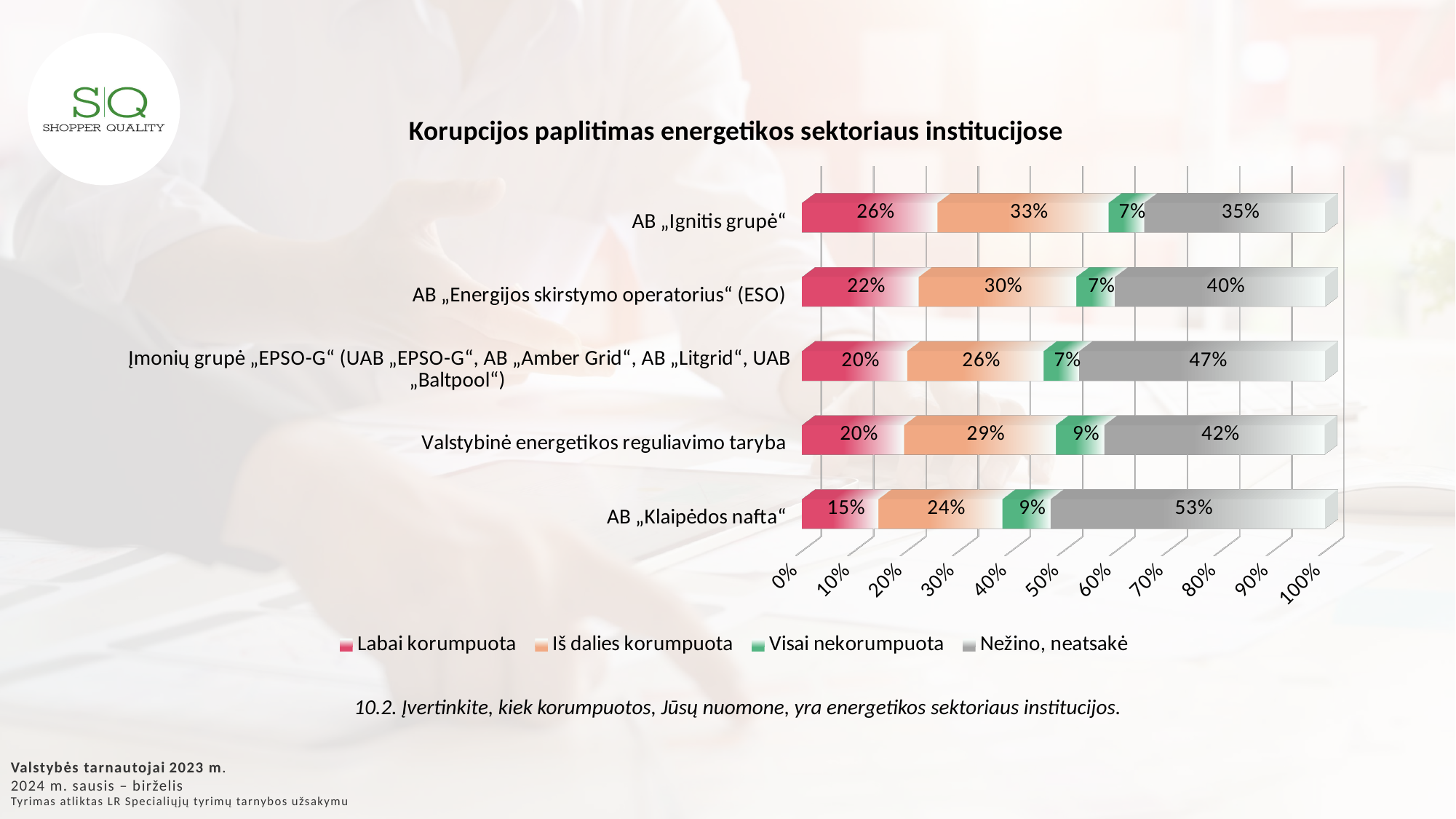
What percentage of respondents rated AB „Ignitis grupė“ as „Labai korumpuota“? 26% What is the „Visai nekorumpuota“ value for Valstybinė energetikos reguliavimo taryba? 9% Which institution has the highest „Labai korumpuota“ share? AB „Ignitis grupė“ What is the title of the chart? Korupcijos paplitimas energetikos sektoriaus institucijose Which institution has the highest „Nežino, neatsakė“ share? AB „Klaipėdos nafta“ How many series does the legend list? 4 Which institution has the lowest „Labai korumpuota“ share? AB „Klaipėdos nafta“ What is the „Nežino, neatsakė“ value for AB „Klaipėdos nafta“? 53% What kind of chart is shown on the slide? Stacked bar chart What is the difference between the „Nežino, neatsakė“ values for AB „Klaipėdos nafta“ and AB „Ignitis grupė“? 18 percentage points Which has a larger „Iš dalies korumpuota“ value: AB „Energijos skirstymo operatorius“ (ESO) or Valstybinė energetikos reguliavimo taryba? AB „Energijos skirstymo operatorius“ (ESO) How many institutions are shown in the chart? 5